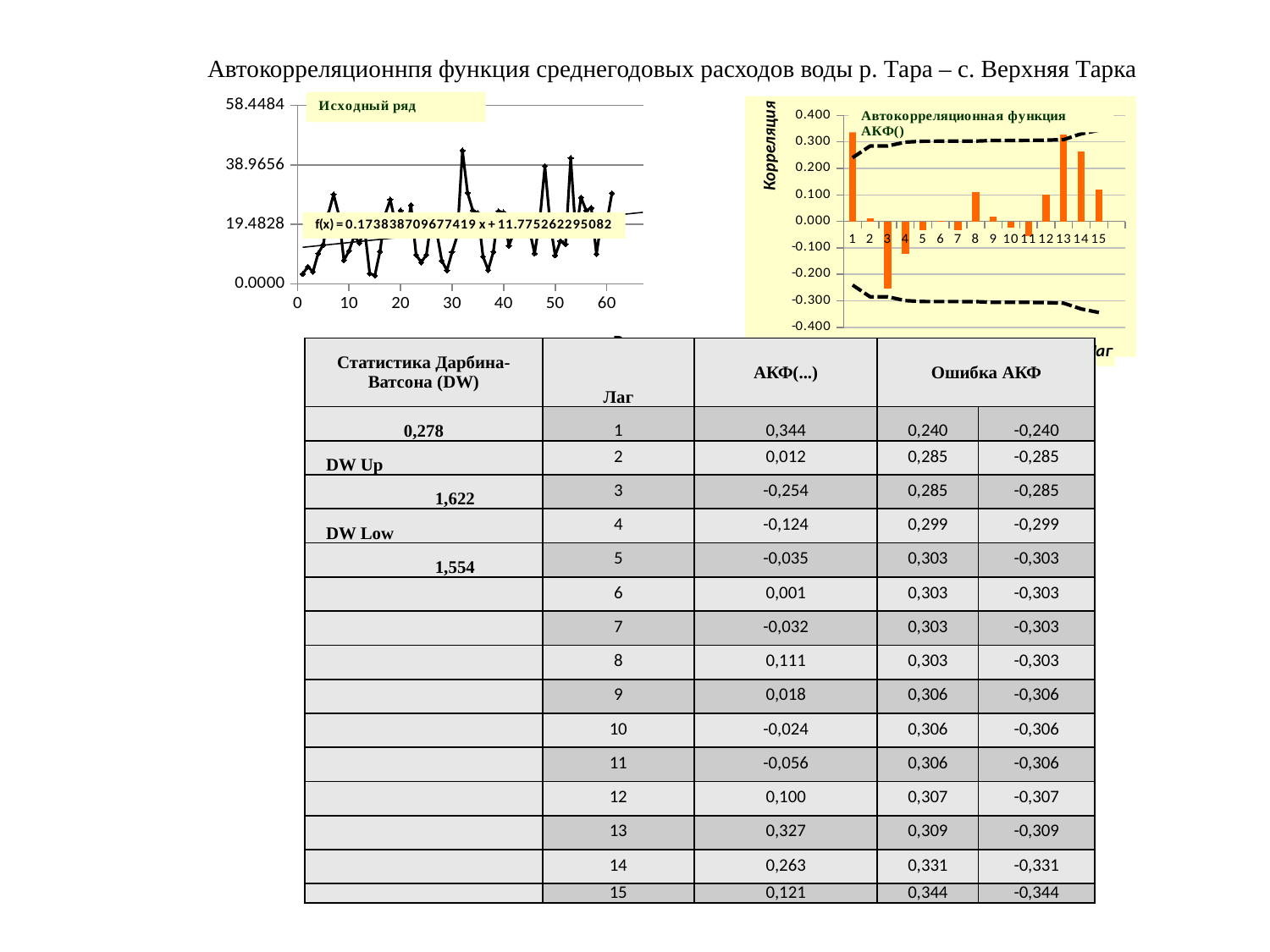
In the 'Автокорреляционная функция АКФ()' chart, which bar is larger, lag 14 or lag 15? lag 14 In the 'Автокорреляционная функция АКФ()' chart, how many lags are plotted as bars? 15 In the 'Автокорреляционная функция АКФ()' chart, is the bar for lag 3 greater or less than -0.200? less In the 'Автокорреляционная функция АКФ()' chart, is the bar for lag 14 greater or less than 0.200? greater In the 'Автокорреляционная функция АКФ()' chart, is the bar for lag 1 greater or less than 0.300? greater In the 'Автокорреляционная функция АКФ()' chart, which bar is larger, lag 1 or lag 3? lag 1 What is the label on the vertical axis of the 'Автокорреляционная функция АКФ()' chart? Корреляция What kind of chart is the left-hand chart titled 'Исходный ряд'? line chart What kind of chart is the right-hand chart titled 'Автокорреляционная функция АКФ()'? combination bar and line chart In the 'Автокорреляционная функция АКФ()' chart, which lag has the lowest (most negative) bar? 3 What is the trend line equation shown on the 'Исходный ряд' chart? f(x) = 0.173838709677419 x + 11.775262295082 In the 'Исходный ряд' chart, does the fitted trend line rise or fall along the x axis? rise